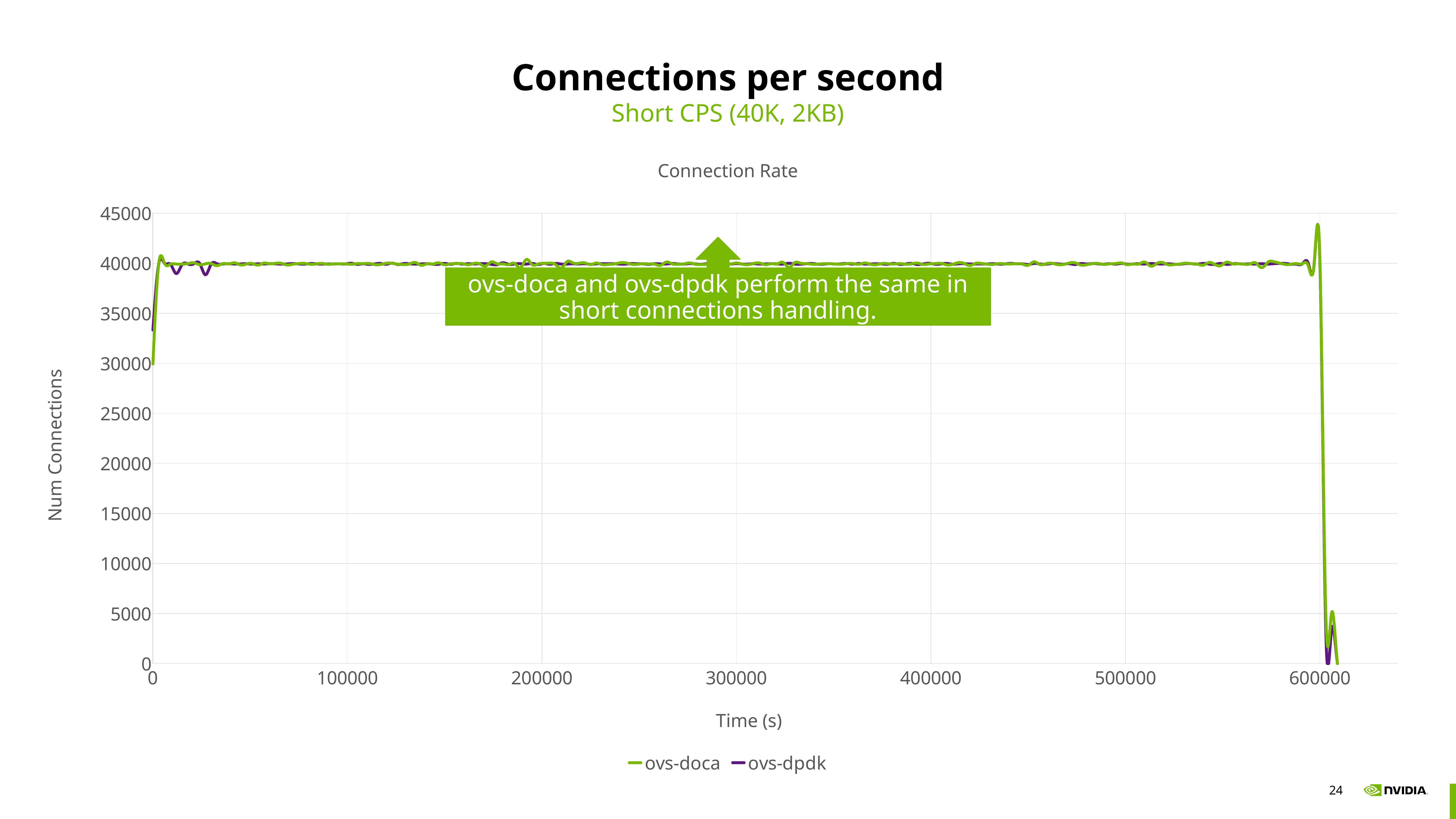
Is the value for ovs-doca at time 100000 greater or less than 30000? greater Is the value for ovs-doca at time 300000 greater or less than 35000? greater How many series does the legend list? 2 Between 100000 and 500000 on the x axis, does the ovs-dpdk line rise, fall, or stay roughly flat? stay roughly flat What is the title of the chart? Connection Rate Does the ovs-doca line rise or fall just after 600000 on the x axis? fall Is the value for ovs-dpdk at time 500000 greater or less than 35000? greater What are the names of the two series in the legend? ovs-doca and ovs-dpdk What kind of chart is shown on the slide? line chart